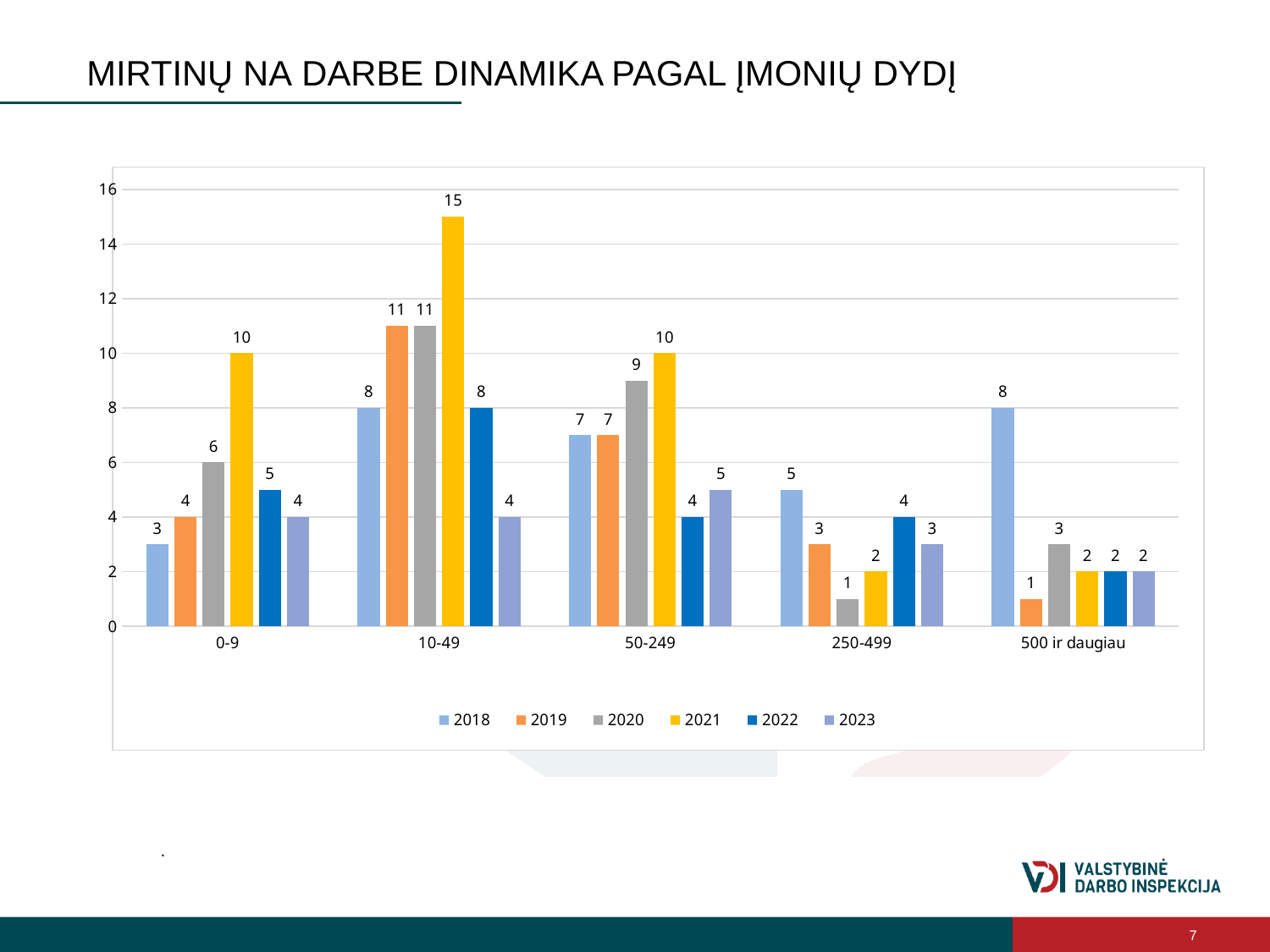
Which category has the highest value for the 2021 series? 10-49 What kind of chart is shown on the slide? Bar chart What is the difference between the 2021 and 2023 values in the 10-49 category? 11 How many series does the legend list? 6 What is the title of the chart? MIRTINŲ NA DARBE DINAMIKA PAGAL ĮMONIŲ DYDĮ What is the value for 2018 in the 500 ir daugiau category? 8 Which category has the lowest value for the 2019 series? 500 ir daugiau What is the value for 2021 in the 10-49 category? 15 Which is larger in the 0-9 category: the 2020 value or the 2022 value? 2020 Does the 2018 series rise or fall from the 250-499 category to the 500 ir daugiau category? Rise How many categories are shown on the x axis? 5 What is the value for 2020 in the 250-499 category? 1